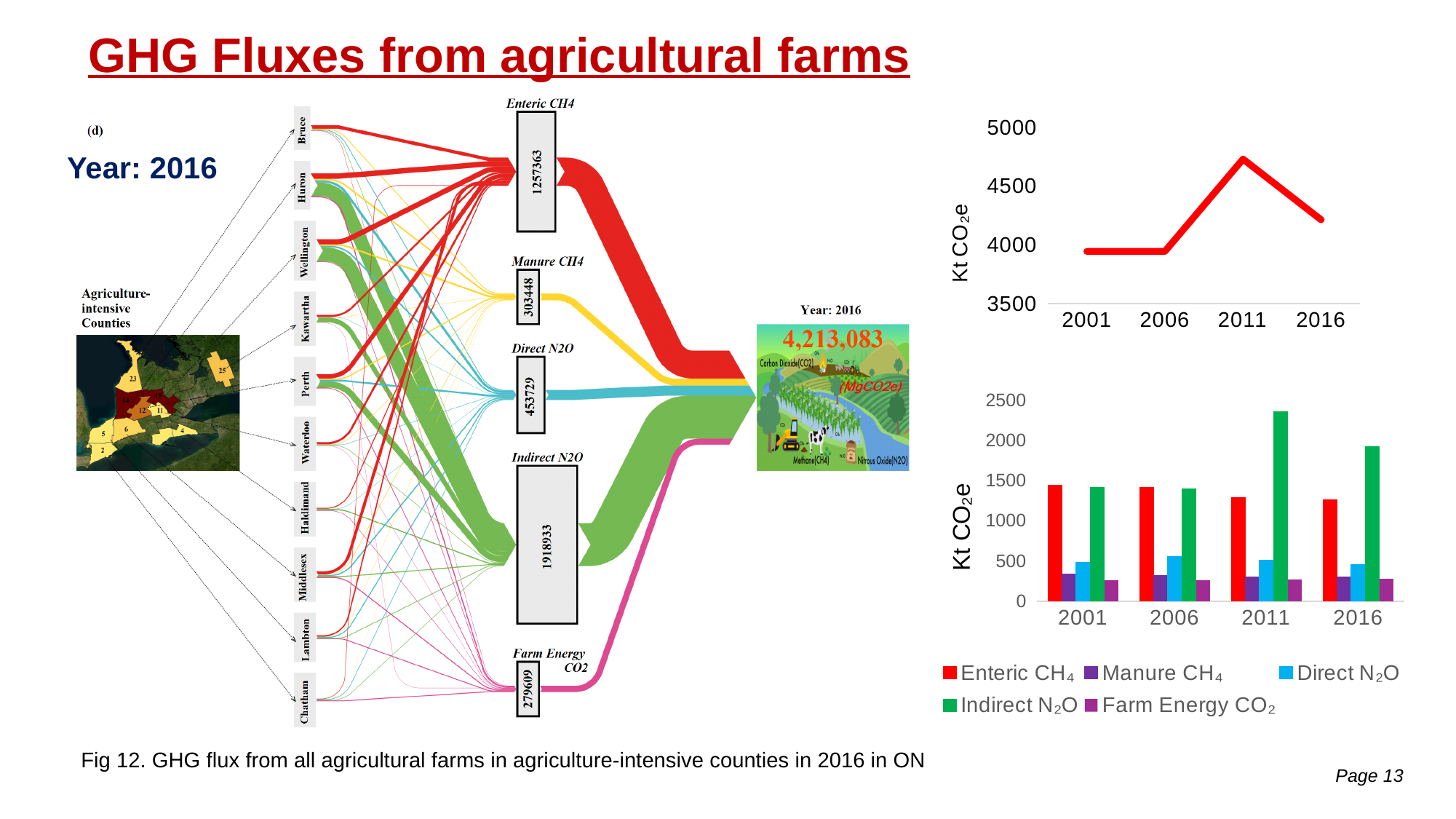
What kind of chart is the top-right chart on the slide? line chart In the top-right line chart, is the value for 2016 greater or less than 4500? less In the bottom-right bar chart, is the Indirect N2O value for 2011 greater or less than 2000? greater In the top-right line chart, which year has the highest value? 2011 In the top-right line chart, is the value for 2011 greater or less than 4500? greater In the bottom-right bar chart, which is larger in 2016: Enteric CH4 or Indirect N2O? Indirect N2O What kind of chart is the bottom-right chart on the slide? bar chart How many years are plotted on the x axis of the top-right line chart? 4 In the bottom-right bar chart, does the Enteric CH4 value rise or fall from 2001 to 2016? fall In the Sankey diagram on the left, what is the value shown for Indirect N2O? 1918933 How many series does the legend of the bottom-right bar chart list? 5 In the bottom-right bar chart, which year has the highest Indirect N2O value? 2011